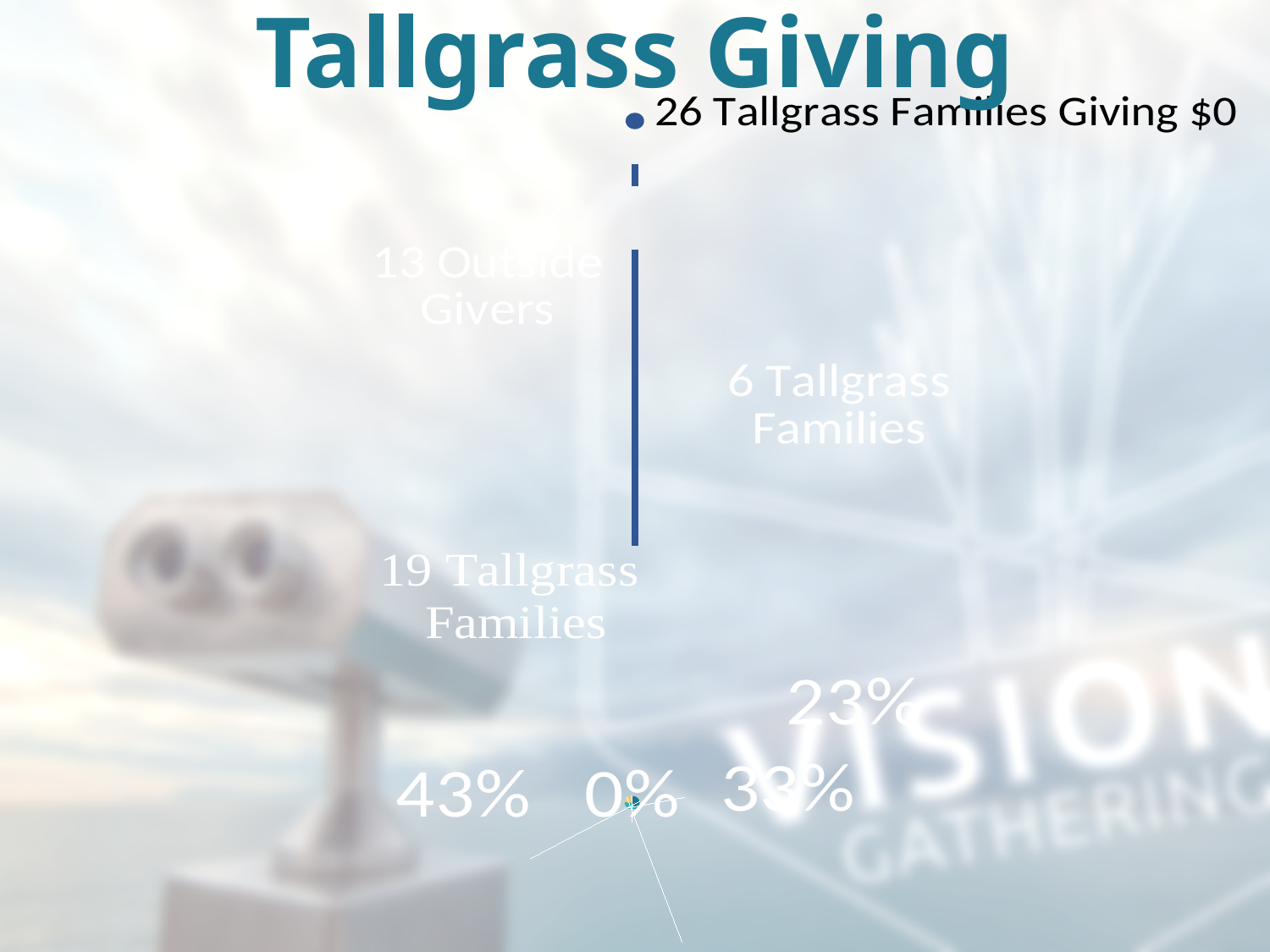
How many percentage data labels are shown on the pie chart? 4 How many families are named in the legend entry as giving $0? 26 What is the smallest percentage label shown on the pie chart? 0% What entry does the chart's legend list? 26 Tallgrass Families Giving $0 What kind of chart is shown on the slide? pie chart What is the title of the slide containing the chart? Tallgrass Giving What is the difference between the largest percentage label (43%) and the 33% label on the pie chart? 10 percentage points What is the largest percentage label shown on the pie chart? 43% Which is larger among the pie chart's labels, 33% or 23%? 33%